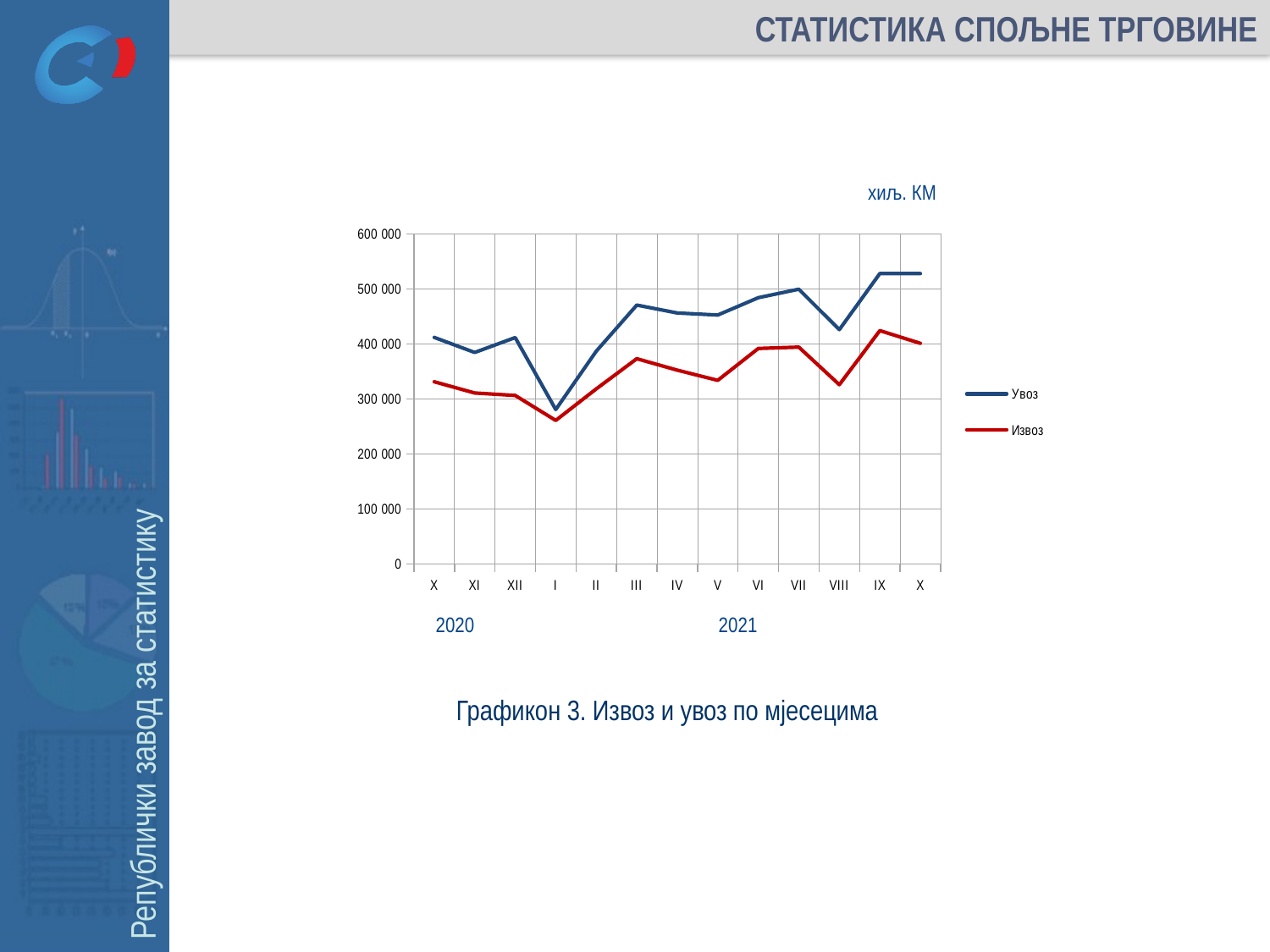
Do the values for Извоз rise or fall from month I to month III of 2021? rise Is the value for Увоз in month I of 2021 greater or less than 300 000? less Which series is higher in month VIII of 2021, Увоз or Извоз? Увоз How many series does the legend list? 2 Is the value for Извоз in month VIII of 2021 greater or less than 400 000? less In which month is the value for Извоз highest? IX (2021) What kind of chart is shown on the slide? line chart In which month is the value for Увоз lowest? I (2021) Which two series are listed in the legend? Увоз and Извоз How many monthly points are plotted along the x axis? 13 Is the value for Увоз in month IX of 2021 greater or less than 500 000? greater In which month is the value for Извоз lowest? I (2021)